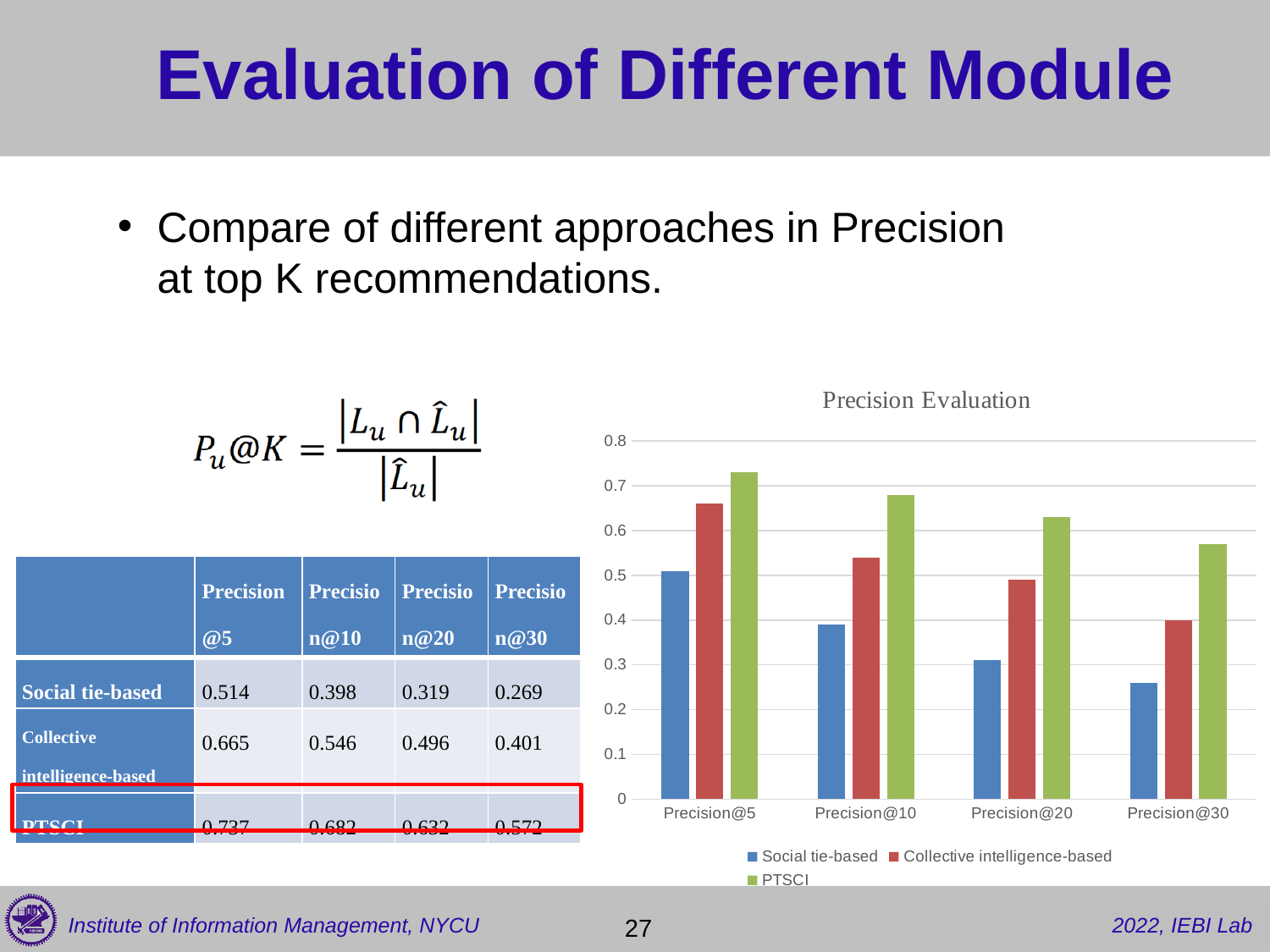
Is the PTSCI value at Precision@5 greater or less than 0.7? greater At Precision@10, which is larger: Collective intelligence-based or Social tie-based? Collective intelligence-based What kind of chart is shown on the slide? bar chart What is the Social tie-based value at Precision@20? 0.319 How many series does the legend of the Precision Evaluation chart list? 3 Is the Social tie-based value at Precision@5 greater or less than 0.6? less What is the title of the chart? Precision Evaluation How many categories are shown on the x axis of the Precision Evaluation chart? 4 What is the difference between the Collective intelligence-based and Social tie-based values at Precision@5? 0.151 Which series has the highest bar at Precision@5? PTSCI Which series has the lowest bar at Precision@30? Social tie-based Do the Social tie-based values rise or fall from Precision@5 to Precision@30? fall